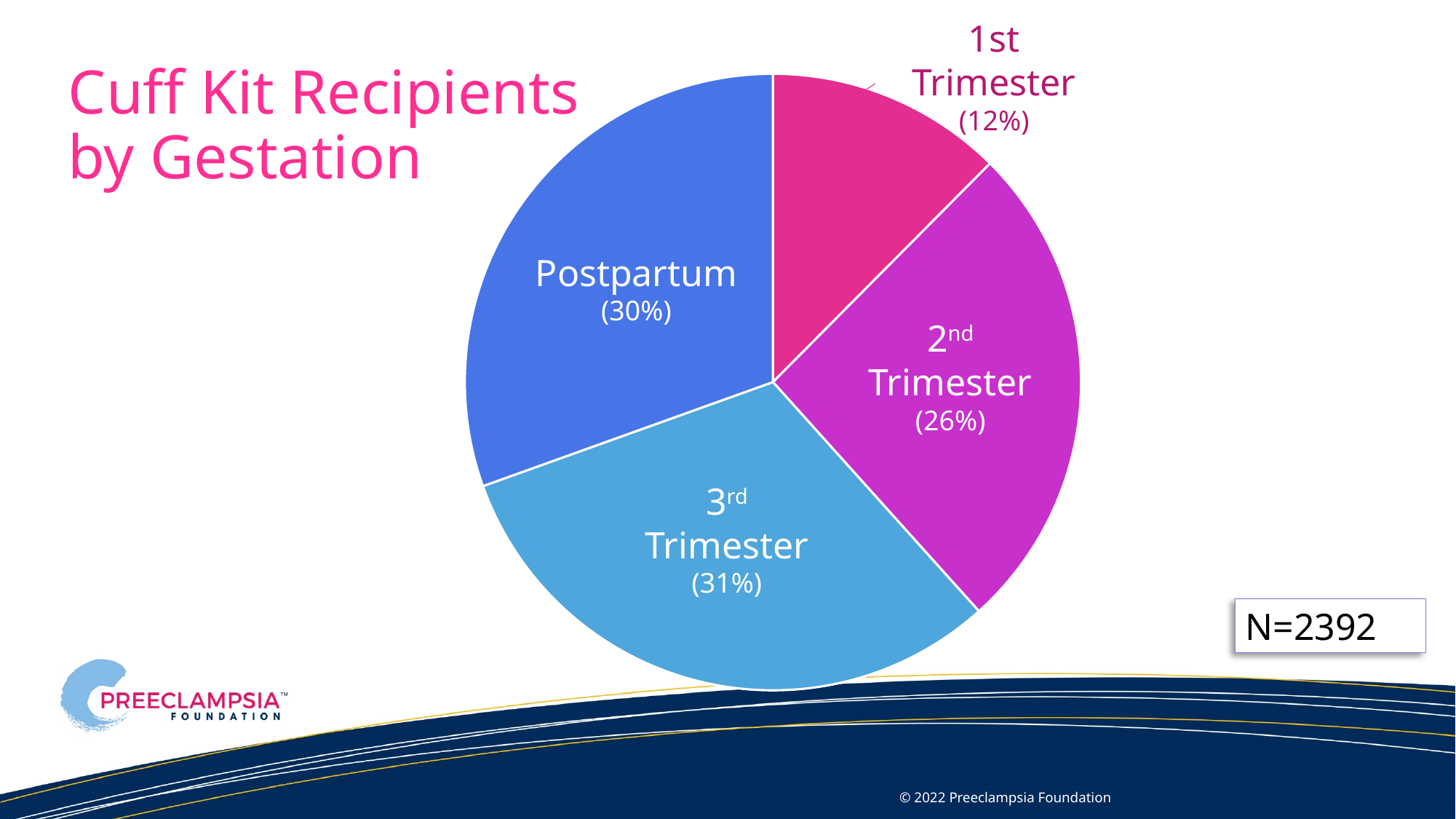
What share of cuff kit recipients were in the 1st Trimester? 12% Which is larger, the 2nd Trimester slice or the Postpartum slice? Postpartum What is the difference in percentage points between the 2nd Trimester and 1st Trimester slices? 14 How many slices does the pie chart have? 4 What share of cuff kit recipients were in the 2nd Trimester? 26% What share of cuff kit recipients were in the 3rd Trimester? 31% Which gestation category has the largest slice of the pie? 3rd Trimester What is the total number of recipients (N) shown on the slide? N=2392 What kind of chart is shown on the slide? Pie chart Which gestation category has the smallest slice of the pie? 1st Trimester What is the title of the chart? Cuff Kit Recipients by Gestation